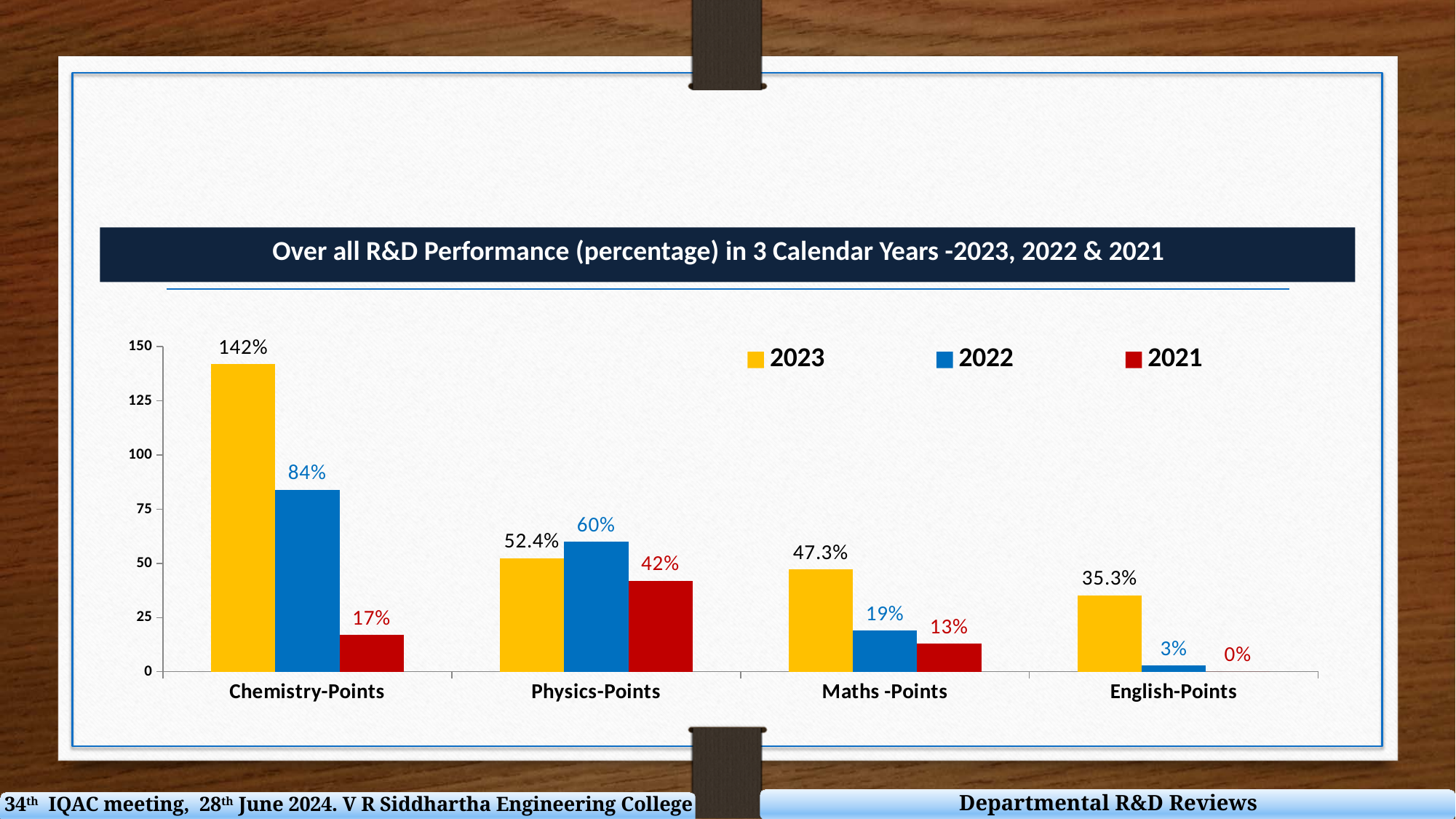
What is the 2023 value for Maths -Points? 47.3% How many series does the legend list? 3 What is the 2023 value for Chemistry-Points? 142% What is the 2021 value for English-Points? 0% Which category has the highest 2023 value? Chemistry-Points What is the title of the chart? Over all R&D Performance (percentage) in 3 Calendar Years -2023, 2022 & 2021 Which category has the lowest 2022 value? English-Points What is the difference between the 2023 and 2022 values for Chemistry-Points? 58% How many categories are shown on the x axis? 4 What is the 2022 value for Physics-Points? 60% For Physics-Points, which is larger: the 2023 value or the 2022 value? 2022 What kind of chart is shown on the slide? Bar chart